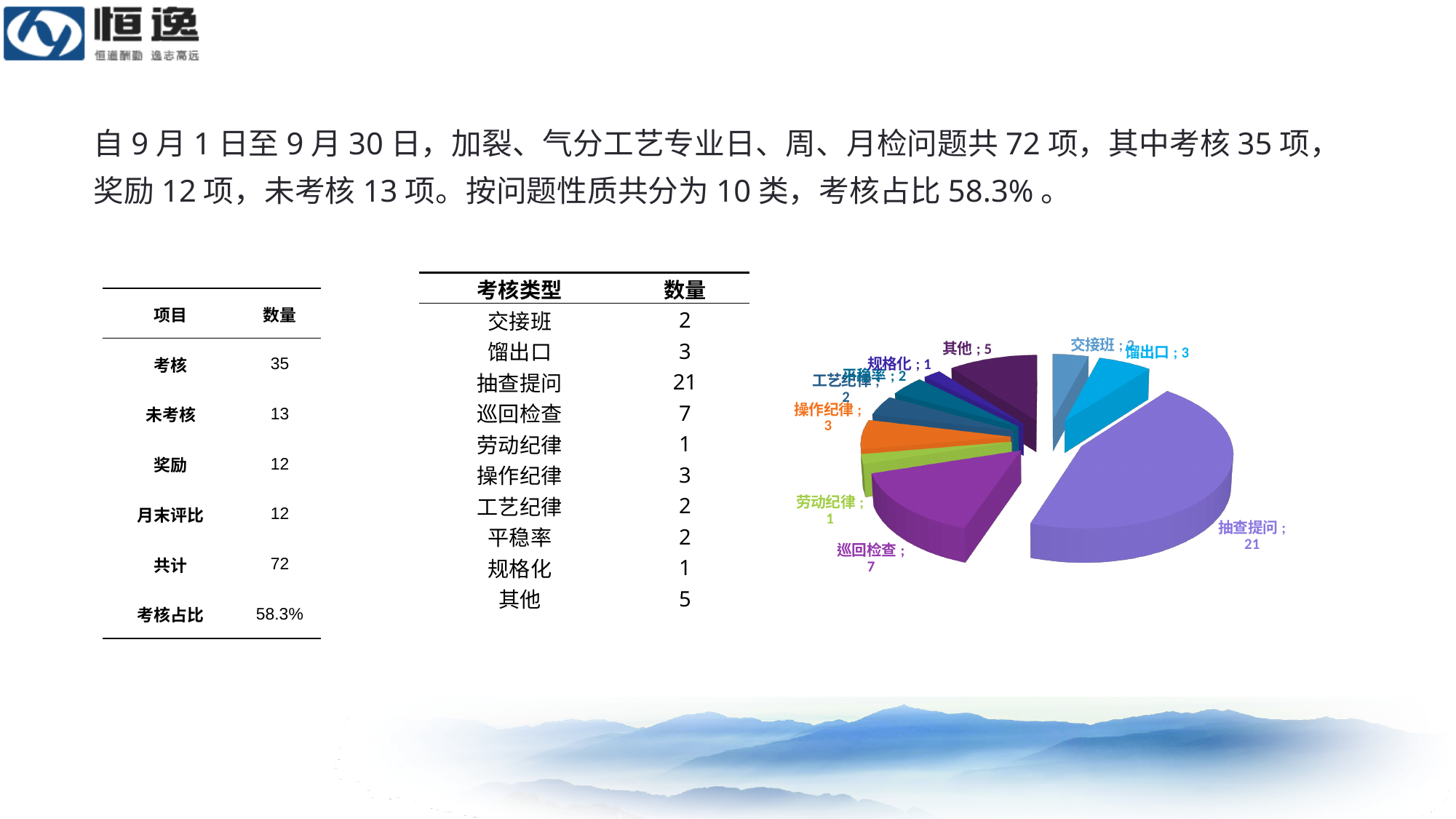
In the pie chart, which is larger, 巡回检查 or 其他? 巡回检查 In the pie chart, what is the value for 抽查提问? 21 What colour is the 抽查提问 slice in the pie chart? purple How many slices does the pie chart have? 10 In the pie chart, which is larger, 馏出口 or 劳动纪律? 馏出口 Which category has the largest slice in the pie chart? 抽查提问 What kind of chart is shown on the slide? pie chart In the pie chart, what is the value for 馏出口? 3 What is the difference between the values for 抽查提问 and 巡回检查 in the pie chart? 14 In the pie chart, what is the value for 巡回检查? 7 What is the difference between the values for 其他 and 操作纪律 in the pie chart? 2 In the pie chart, what is the value for 其他? 5